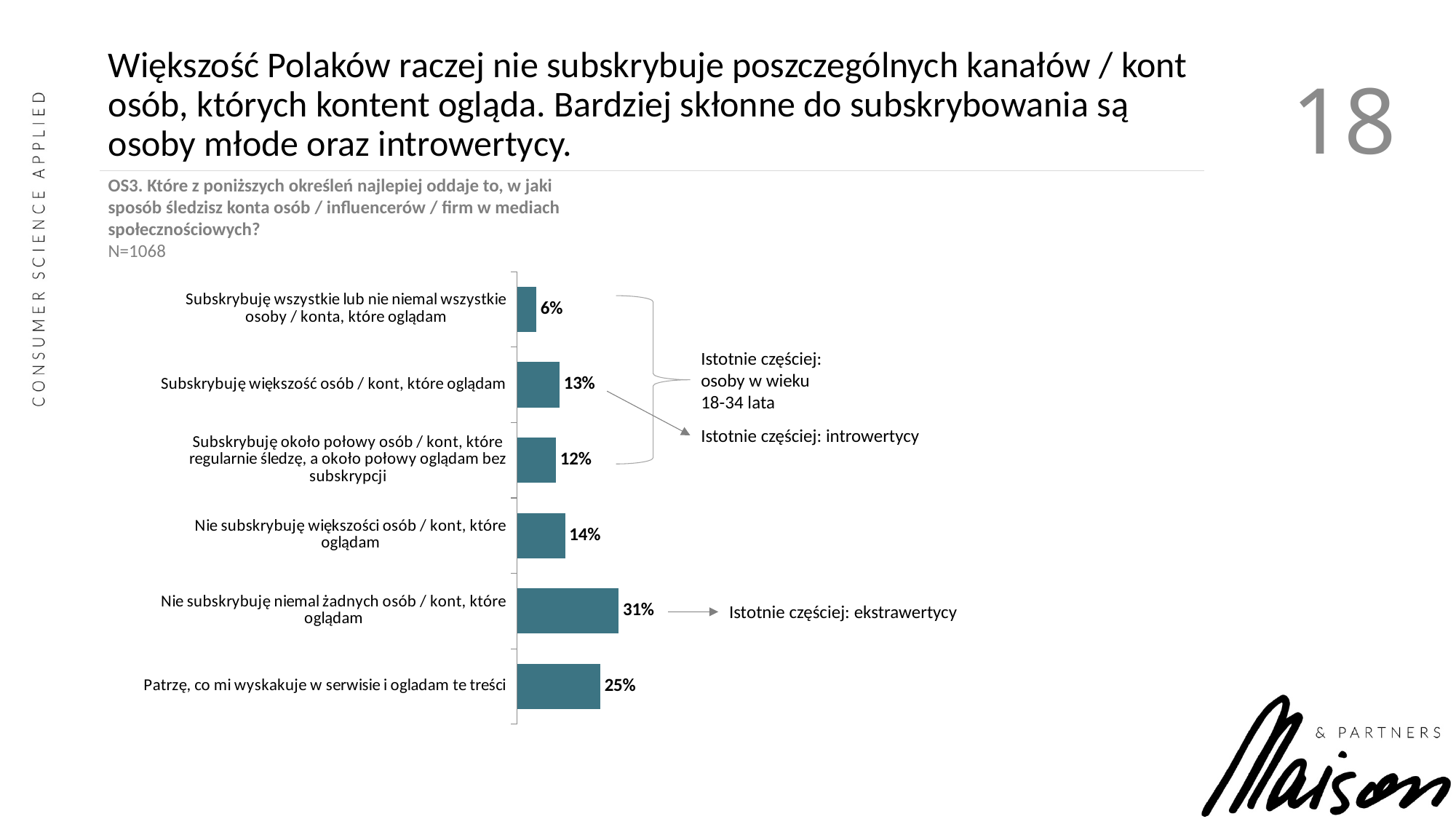
What is the value for "Patrzę, co mi wyskakuje w serwisie i ogladam te treści"? 25% What kind of chart is shown on the slide? Bar chart Which is larger: the value for "Nie subskrybuję większości osób / kont, które oglądam" or the value for "Subskrybuję około połowy osób / kont, które regularnie śledzę, a około połowy oglądam bez subskrypcji"? Nie subskrybuję większości osób / kont, które oglądam What is the value for "Nie subskrybuję niemal żadnych osób / kont, które oglądam"? 31% What is the sample size (N) stated for the chart? N=1068 Which category has the highest value? Nie subskrybuję niemal żadnych osób / kont, które oglądam What percentage of respondents say they subscribe to all or almost all of the people / accounts they watch ("Subskrybuję wszystkie lub nie niemal wszystkie osoby / konta, które oglądam")? 6% How many categories are shown in the chart? 6 Which category has the lowest value? Subskrybuję wszystkie lub nie niemal wszystkie osoby / konta, które oglądam According to the annotation, which group significantly more often chose "Nie subskrybuję niemal żadnych osób / kont, które oglądam"? Ekstrawertycy What is the difference between the value for "Nie subskrybuję niemal żadnych osób / kont, które oglądam" and the value for "Patrzę, co mi wyskakuje w serwisie i ogladam te treści"? 6% What is the value for "Subskrybuję większość osób / kont, które oglądam"? 13%